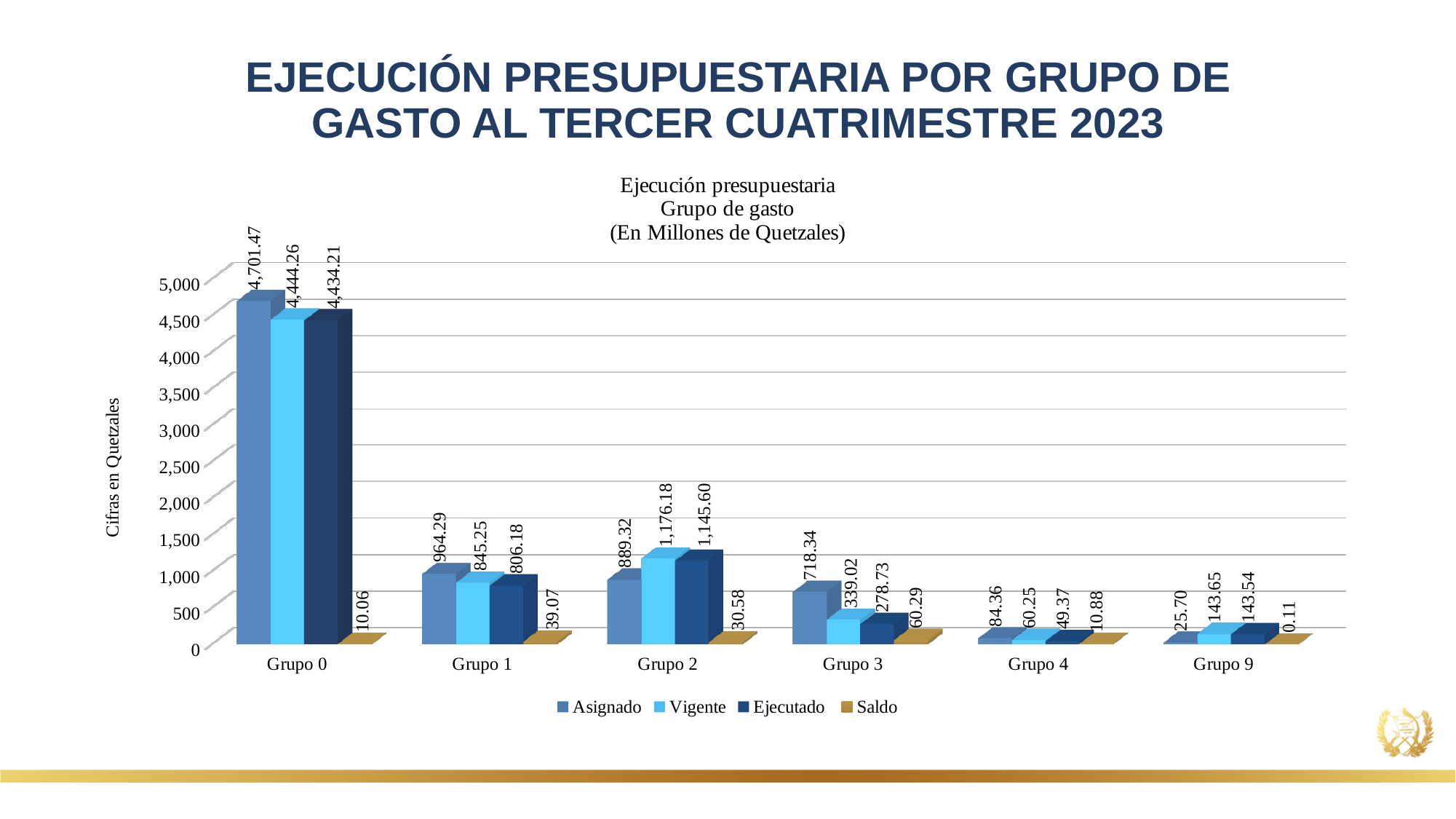
What kind of chart is shown on the slide? bar chart Which group has the highest Asignado value? Grupo 0 Which group has the lowest Saldo value? Grupo 9 How many series does the legend list? 4 What is the Saldo value for Grupo 3? 60.29 How many groups (categories) are shown on the x axis? 6 For Grupo 2, which is larger: the Asignado value or the Vigente value? Vigente What is the difference between the Vigente and Ejecutado values for Grupo 1? 39.07 Is the Ejecutado value for Grupo 3 greater or less than 500? less What is the Ejecutado value for Grupo 9? 143.54 What is the Vigente value for Grupo 2? 1,176.18 What is the Asignado value for Grupo 0? 4,701.47